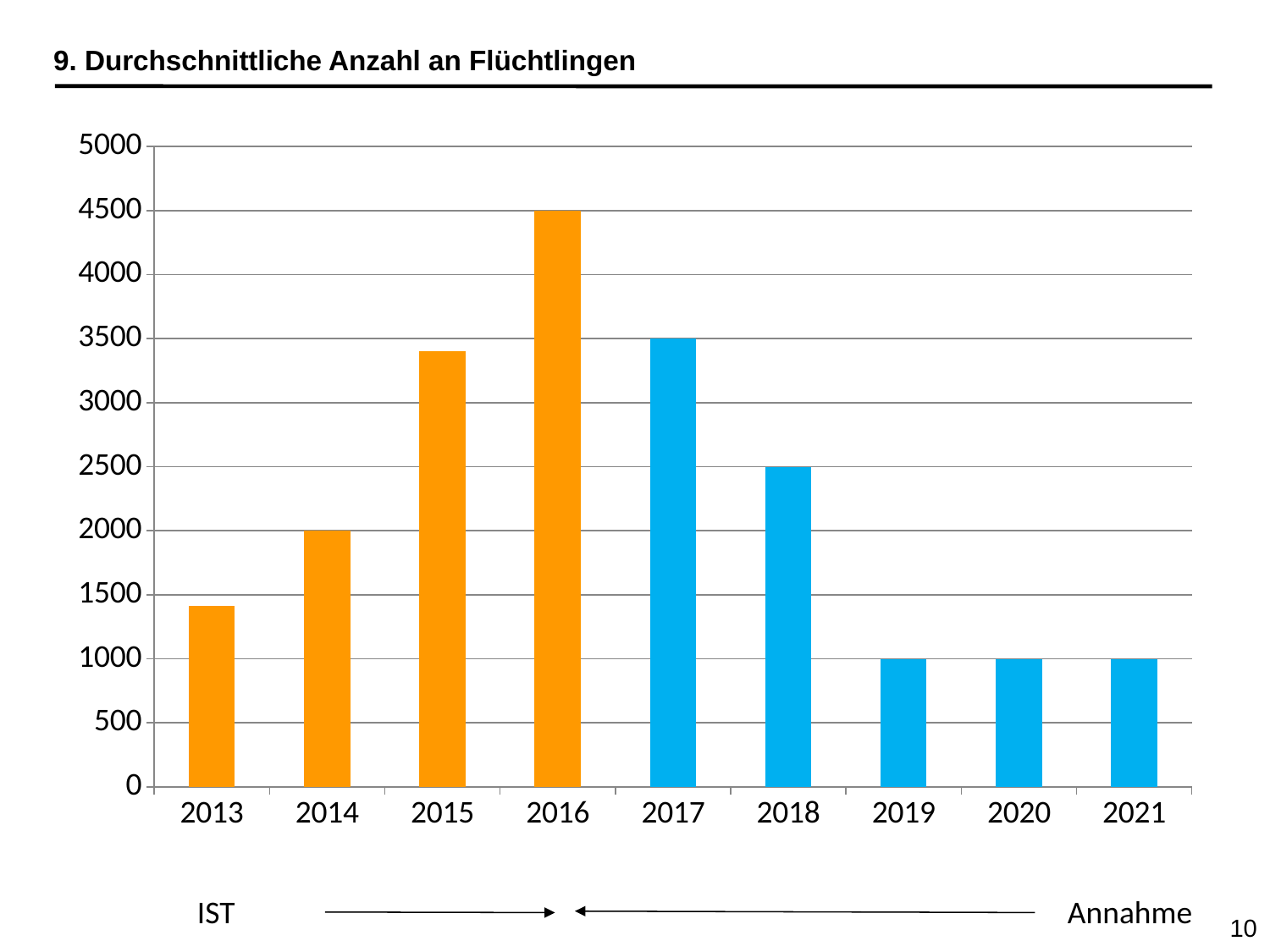
Which year has the highest bar in the chart? 2016 Which is larger, the value for 2015 or the value for 2018? 2015 What is the value for 2018? 2500 What is the value for 2017? 3500 Is the value for 2013 greater or less than 1500? less What is the difference between the values for 2016 and 2017? 1000 What is the value for 2016? 4500 What kind of chart is shown on the slide? bar chart Is the value for 2015 greater or less than 3000? greater What is the value for 2020? 1000 How many years are shown on the x axis of the chart? 9